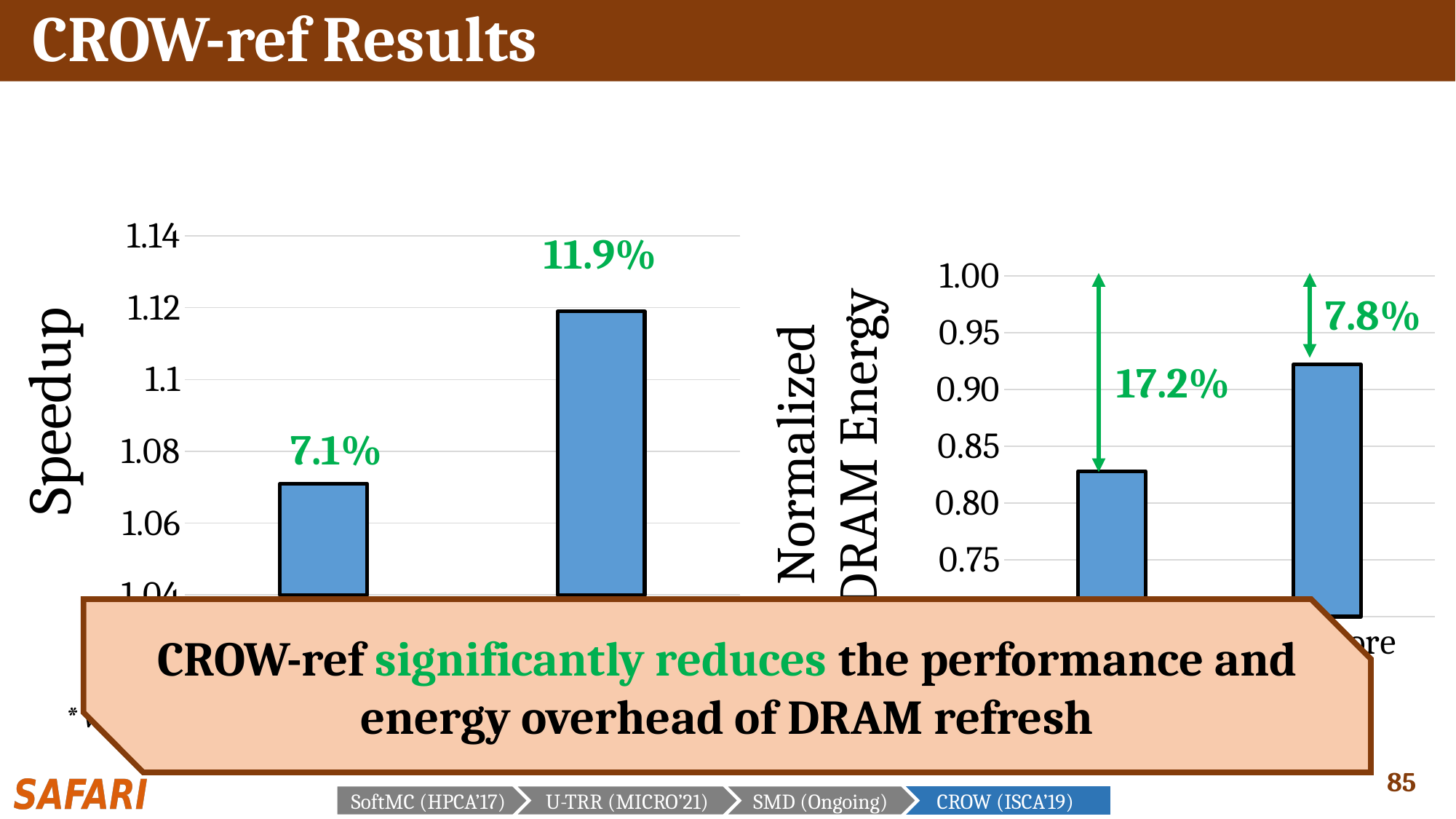
In the Normalized DRAM Energy chart on the right, is the value of the right bar greater or less than 0.90? greater How many bars are plotted in the Speedup chart on the left? 2 In the Speedup chart on the left, what percentage label is printed above the left bar? 7.1% In the Normalized DRAM Energy chart on the right, what percentage is printed next to the green arrow above the right bar? 7.8% In the Normalized DRAM Energy chart on the right, what percentage is printed next to the green arrow above the left bar? 17.2% In the Speedup chart on the left, is the value of the left bar greater or less than 1.08? less In the Normalized DRAM Energy chart on the right, is the value of the left bar greater or less than 0.85? less In the Speedup chart on the left, what percentage label is printed above the right bar? 11.9% What kind of chart is the Speedup chart on the left of the slide? bar chart In the Speedup chart on the left, which bar is taller, the left bar or the right bar? the right bar What is the y-axis title of the chart on the right of the slide? Normalized DRAM Energy